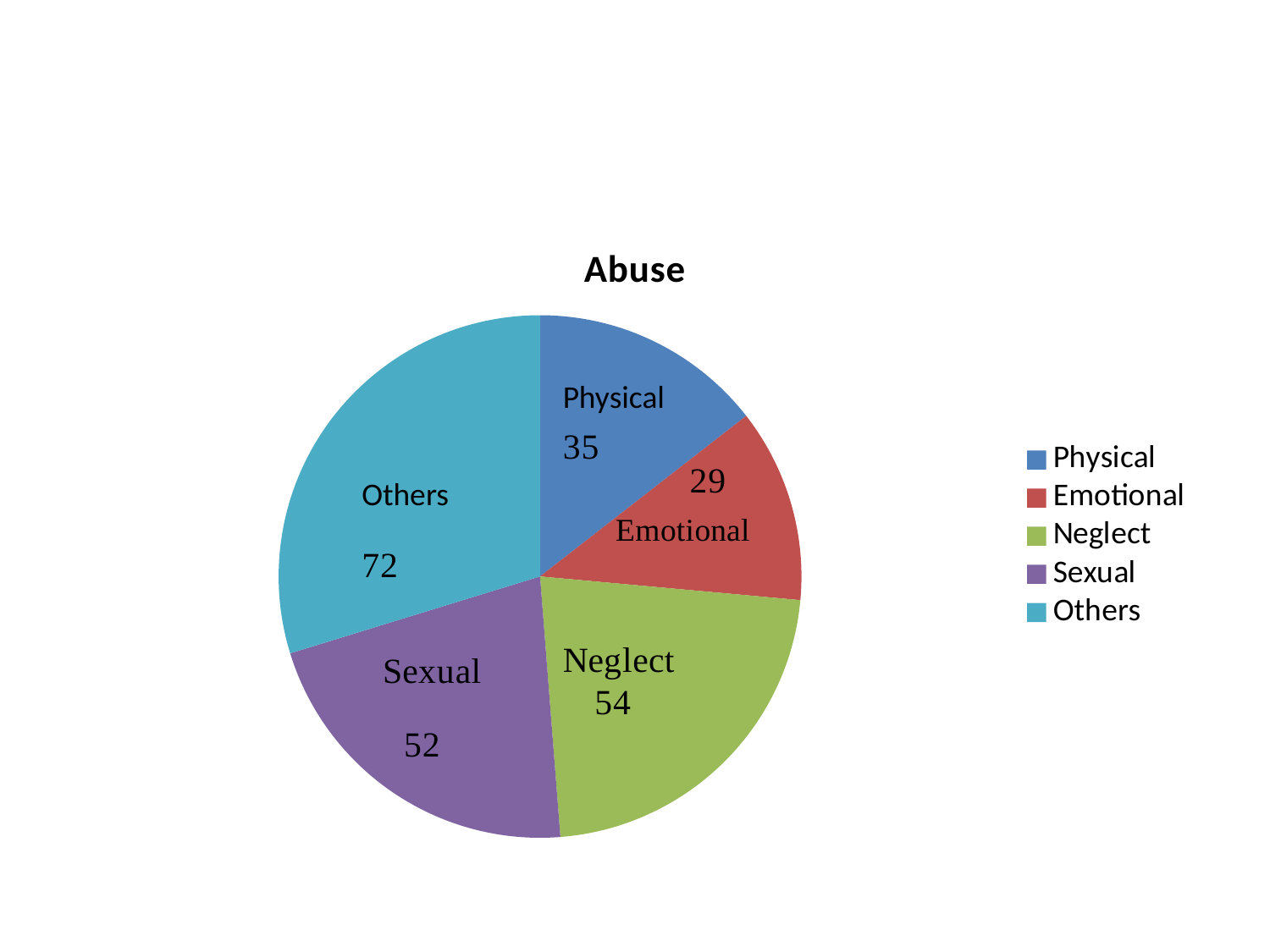
What is the title of the chart? Abuse Which category has the smallest slice? Emotional Which is larger, Neglect or Sexual? Neglect What is the value for Others? 72 What is the value for Emotional? 29 What kind of chart is shown on the slide? pie chart Which category has the largest slice? Others What is the total of all the slices in the pie chart? 242 What is the difference between the values for Others and Physical? 37 What is the value for Neglect? 54 What is the value for Physical? 35 How many categories does the pie chart have? 5